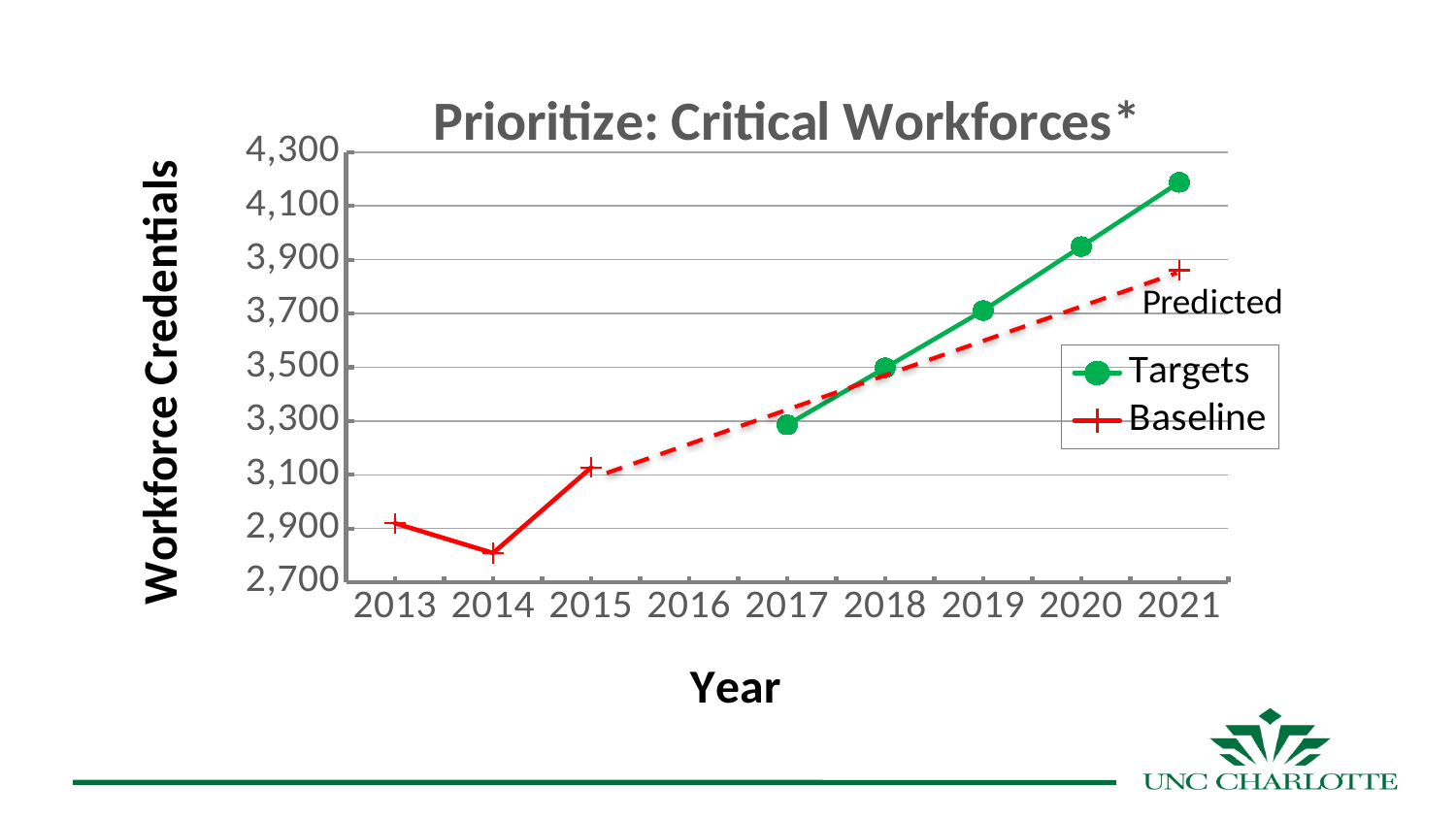
How many series does the legend list? 2 What kind of chart is shown on the slide? Line chart Is the Baseline value for 2014 greater or less than 2,900? less What is the title of the chart? Prioritize: Critical Workforces* How many years are shown on the x axis? 9 In 2021, which series has the larger value, Targets or Baseline? Targets In which year is the Targets series at its highest? 2021 What is the label on the vertical axis? Workforce Credentials Is the Targets value for 2020 greater or less than 3,900? greater Is the Targets value for 2021 greater or less than 4,100? greater In which year is the Baseline series at its lowest? 2014